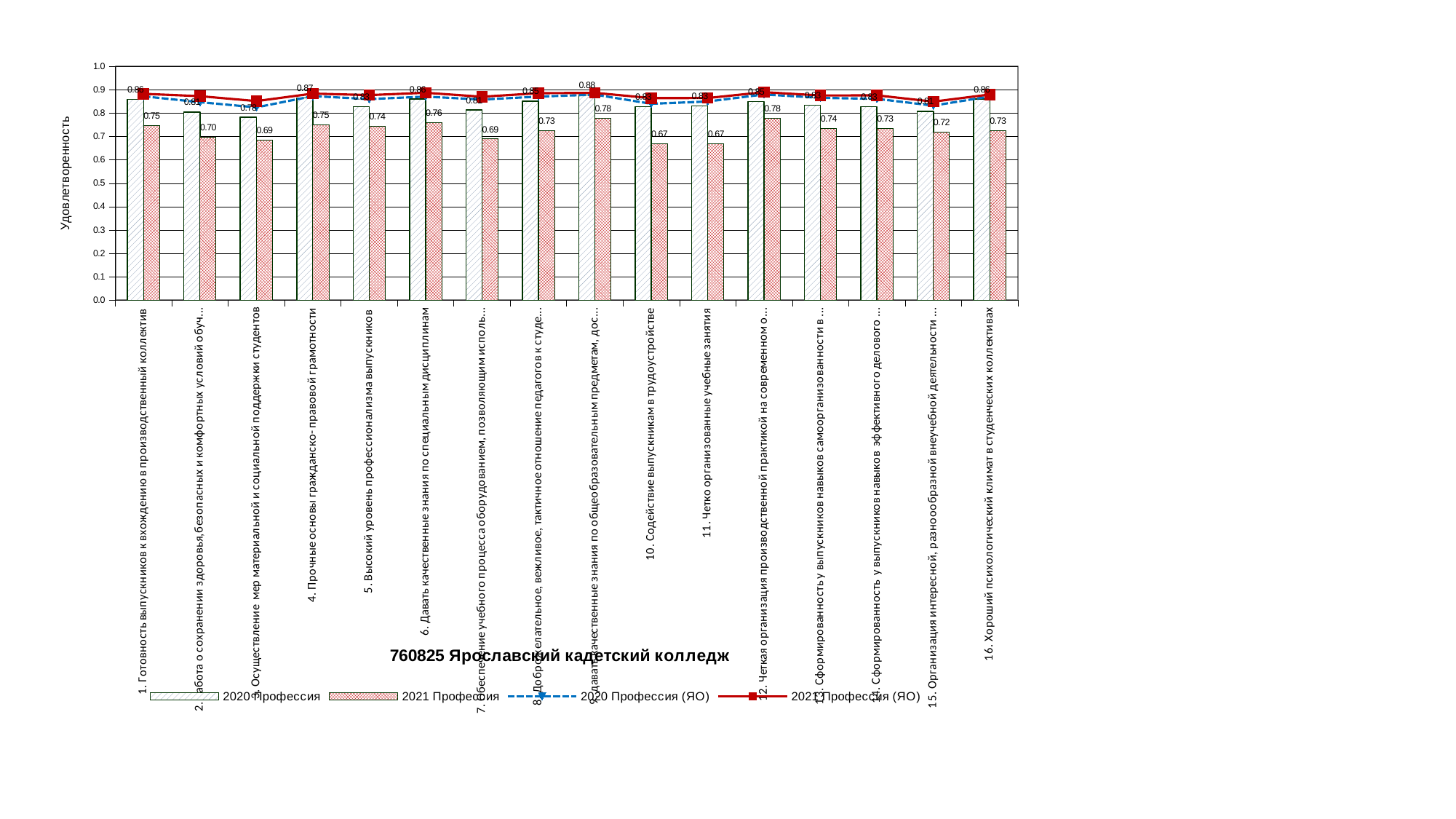
What kind of chart is shown on the slide? A combined bar and line chart How many categories are plotted along the x axis? 16 What is the difference between the 2020 Профессия and 2021 Профессия values for category 1? 0.11 How many series does the legend list? 4 What is the 2020 Профессия value for category 3 (Осуществление мер материальной и социальной поддержки студентов)? 0.78 What is the 2020 Профессия value for category 4 (Прочные основы гражданско-правовой грамотности)? 0.87 Is the 2021 Профессия value for category 2 greater or less than 0.8? less What is the 2021 Профессия value for category 1 (Готовность выпускников к вхождению в производственный коллектив)? 0.75 What is the 2021 Профессия value for category 10 (Содействие выпускникам в трудоустройстве)? 0.67 Which has the larger 2021 Профессия value: category 9 or category 10? Category 9 What is the title of the chart? 760825 Ярославский кадетский колледж What is the 2021 Профессия value for category 16 (Хороший психологический климат в студенческих коллективах)? 0.73